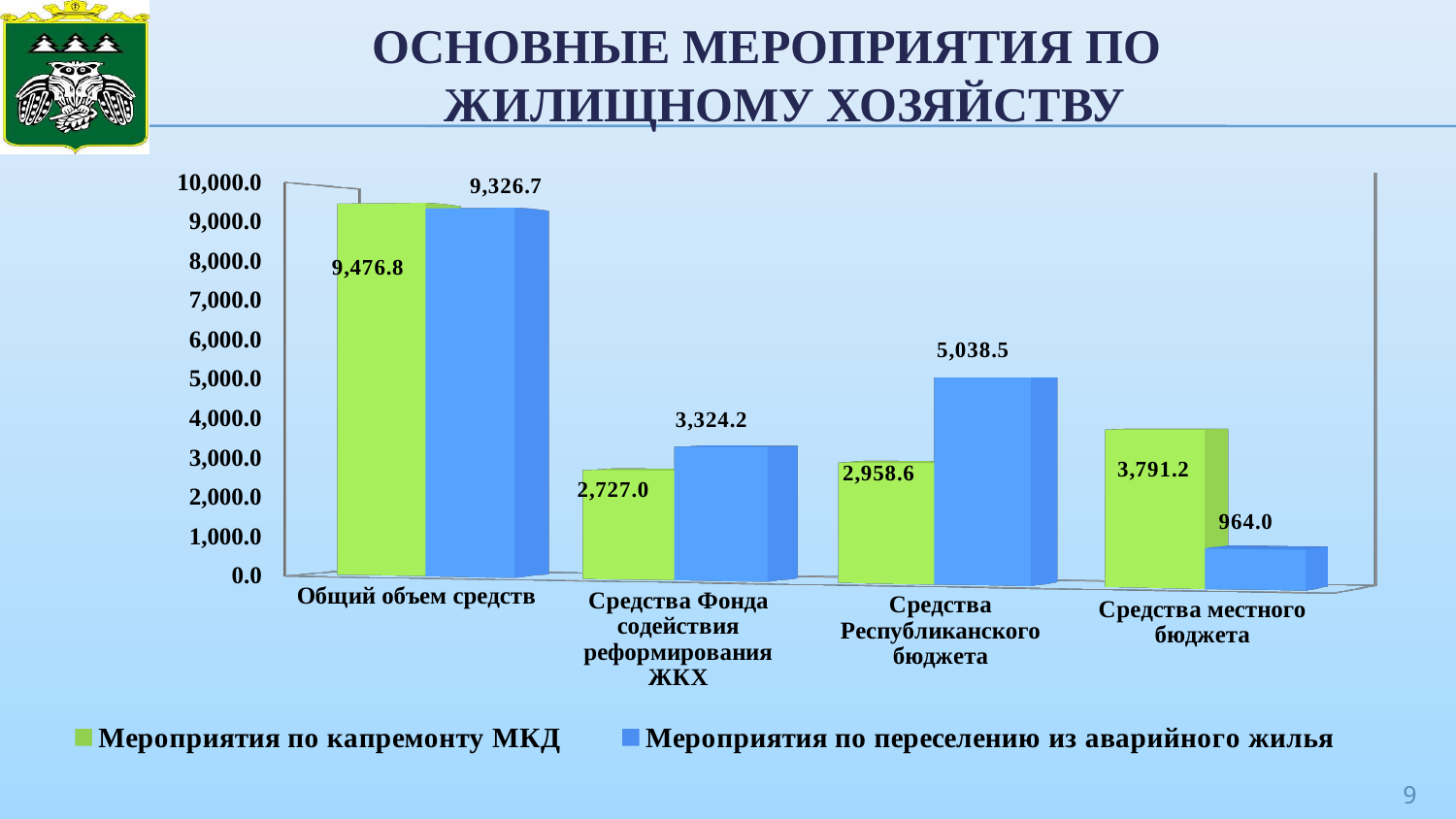
What is the value for "Мероприятия по капремонту МКД" in the category "Средства Фонда содействия реформирования ЖКХ"? 2,727.0 Which colour represents "Мероприятия по переселению из аварийного жилья" in the chart? Blue What is the value for "Мероприятия по капремонту МКД" in the category "Общий объем средств"? 9,476.8 What is the value for "Мероприятия по переселению из аварийного жилья" in the category "Средства Республиканского бюджета"? 5,038.5 What kind of chart is shown on the slide? Bar chart In the category "Средства местного бюджета", which series has the larger value? Мероприятия по капремонту МКД What is the difference between the two series in the category "Средства Республиканского бюджета"? 2,079.9 How many series does the legend list? 2 How many categories are shown on the x axis? 4 Which category has the lowest value for "Мероприятия по переселению из аварийного жилья"? Средства местного бюджета Which category has the highest value for "Мероприятия по капремонту МКД"? Общий объем средств What is the value for "Мероприятия по переселению из аварийного жилья" in the category "Средства местного бюджета"? 964.0